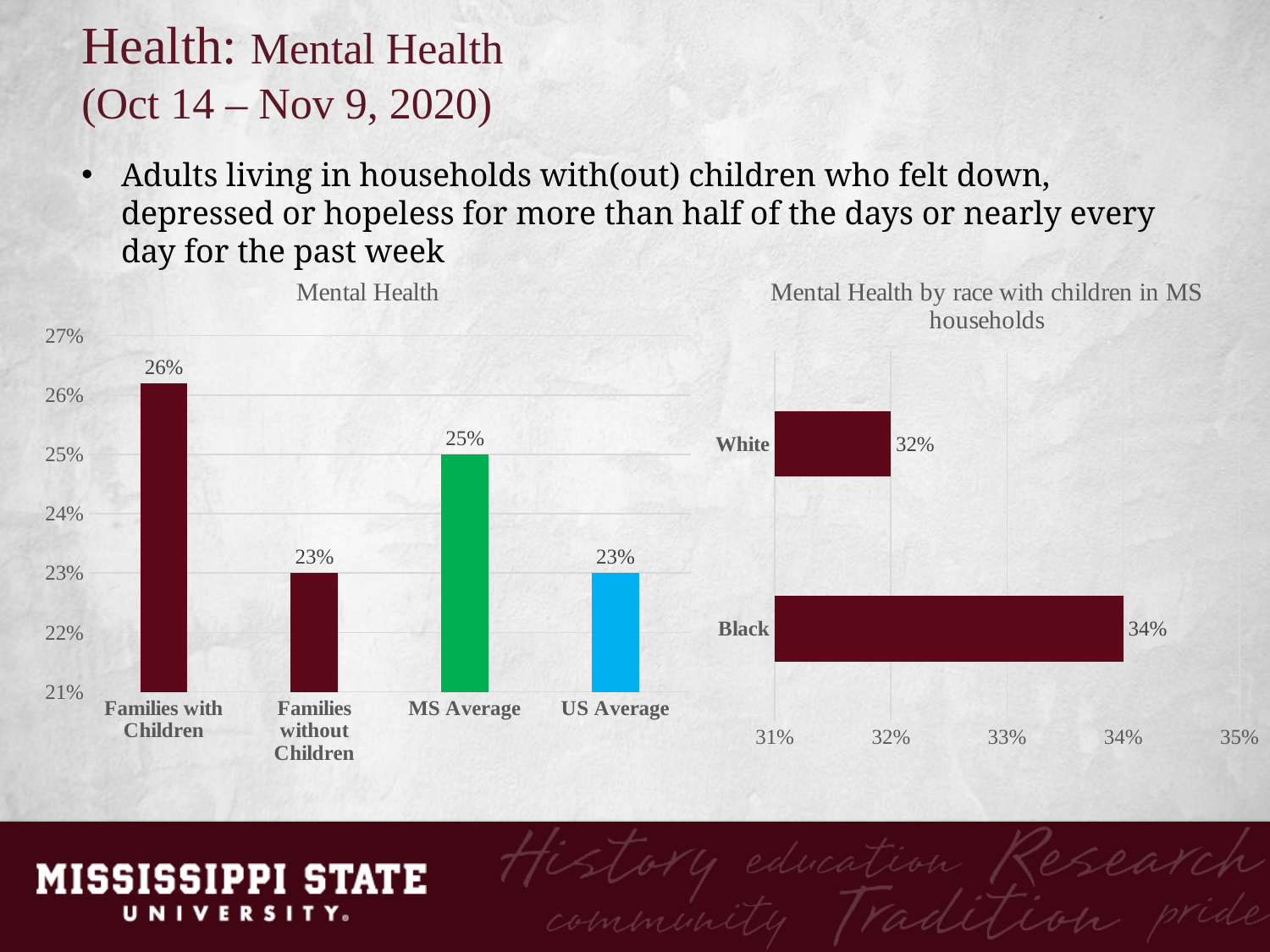
In the "Mental Health" chart, which is larger: MS Average or US Average? MS Average In the "Mental Health by race with children in MS households" chart, what is the difference between Black and White? 2% In the "Mental Health by race with children in MS households" chart, what is the value for Black? 34% In the "Mental Health" chart, which category has the highest value? Families with Children In the "Mental Health by race with children in MS households" chart, what is the value for White? 32% In the "Mental Health by race with children in MS households" chart, which category has the lowest value? White In the "Mental Health" chart, what is the value for Families with Children? 26% In the "Mental Health" chart, what is the difference between Families with Children and Families without Children? 3% In the "Mental Health" chart, how many categories are shown? 4 What kind of chart is the "Mental Health" chart? Bar chart In the "Mental Health" chart, what colour is the US Average bar? Blue In the "Mental Health" chart, what is the value for MS Average? 25%